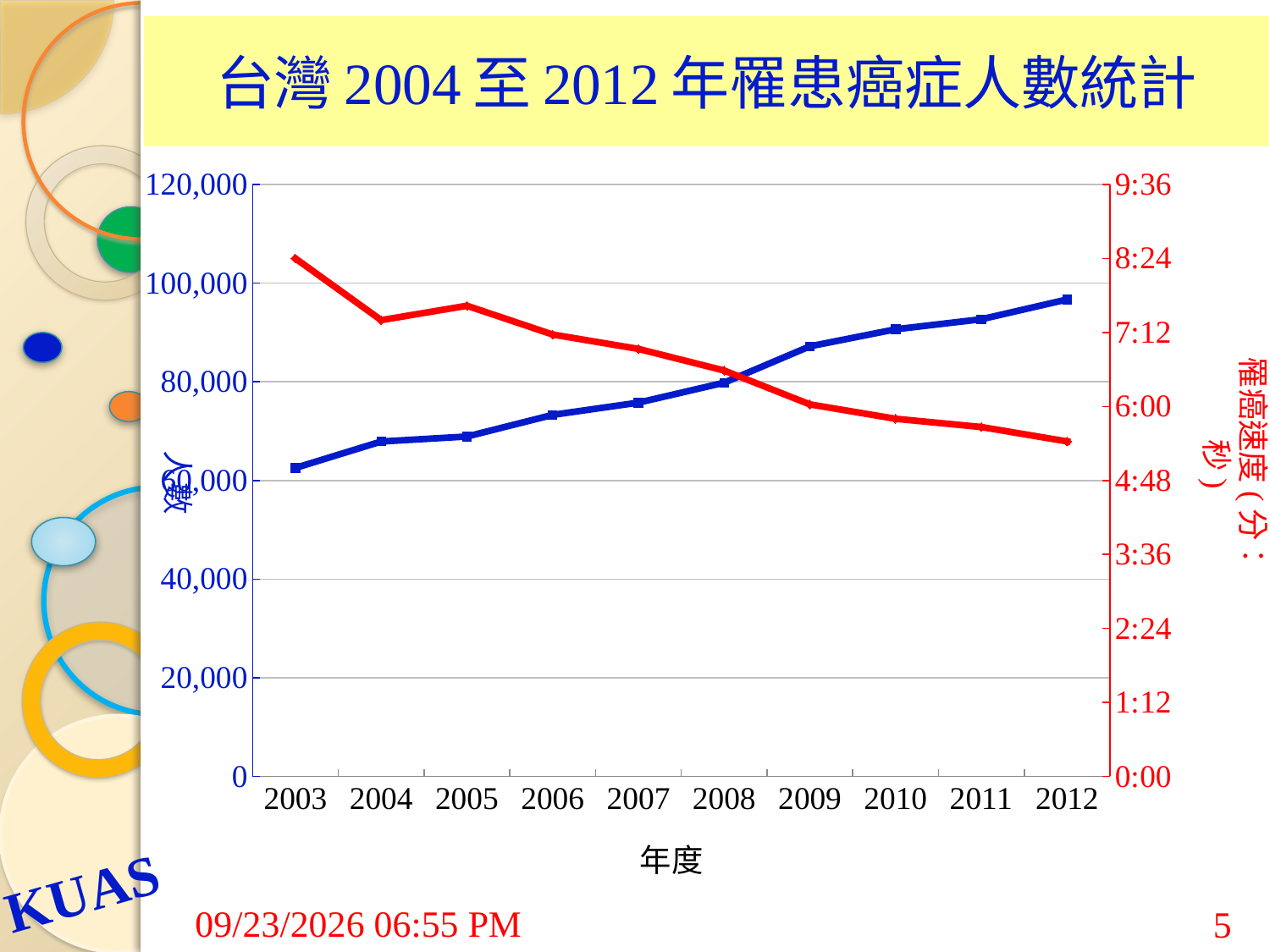
Does the blue line (人數) rise or fall from 2003 to 2012? rise What is the title of the chart on the slide? 台灣 2004 至 2012 年罹患癌症人數統計 In which year is the blue line (人數) at its highest? 2012 What is the label of the x axis of the chart? 年度 Is the value of the blue line (人數) for 2012 greater or less than 100,000? less In which year is the red line (罹癌速度) at its highest? 2003 In which year is the blue line (人數) at its lowest? 2003 Does the red line (罹癌速度) rise or fall from 2003 to 2012? fall Is the value of the blue line (人數) for 2003 greater or less than 80,000? less How many years are shown along the x axis of the chart? 10 Is the value of the red line (罹癌速度) for 2012 greater or less than 6:00? less What kind of chart is shown on the slide? line chart